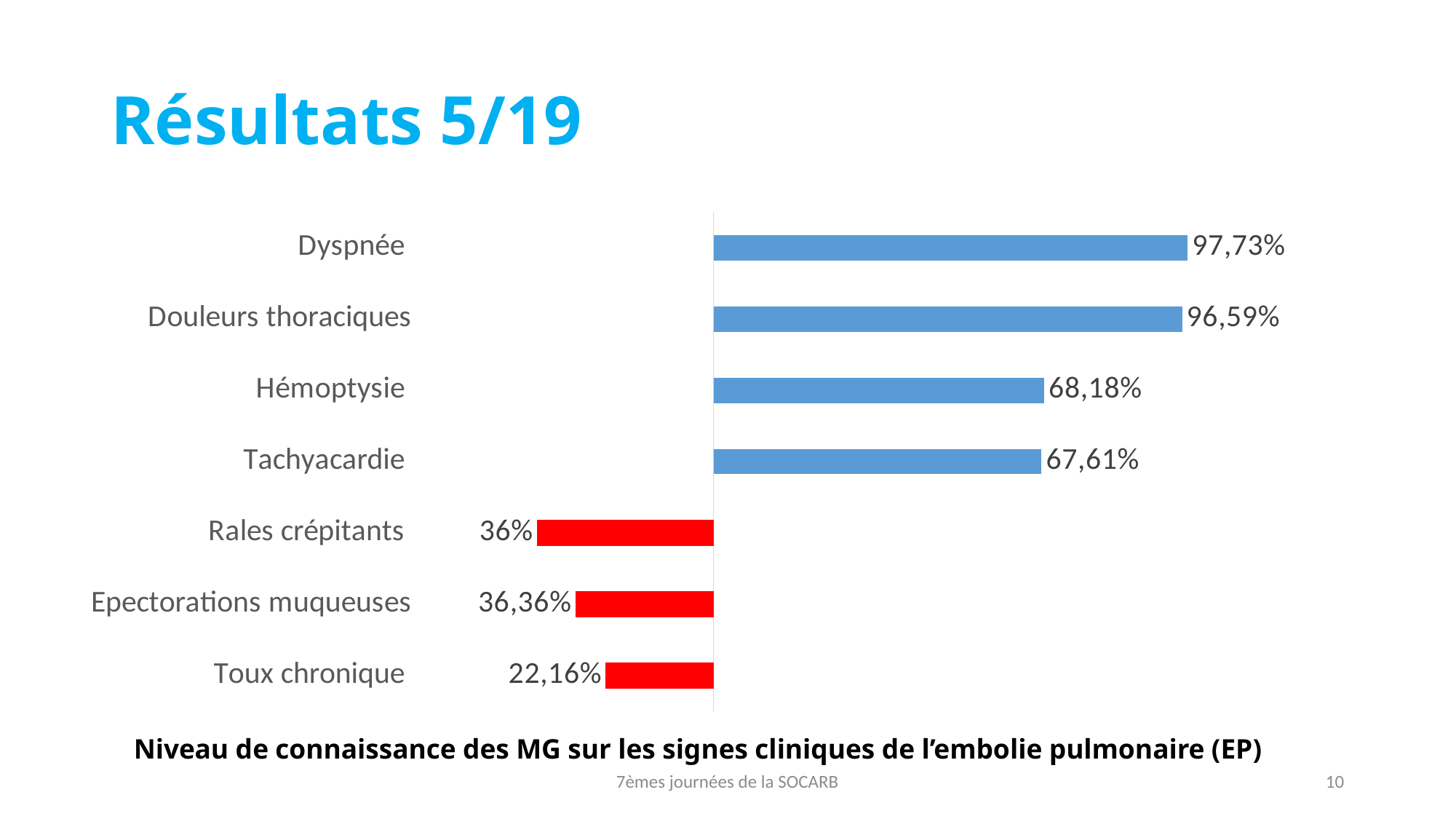
Which category has the highest value? Dyspnée What is the value shown for Epectorations muqueuses? 36,36% What is the value shown for Douleurs thoraciques? 96,59% What is the value shown for Hémoptysie? 68,18% What kind of chart is shown on the slide? Bar chart What is the difference between the values for Dyspnée and Douleurs thoraciques? 1,14 percentage points What is the value shown for Tachyacardie? 67,61% Which is larger, the value for Hémoptysie or the value for Toux chronique? Hémoptysie What is the value shown for Toux chronique? 22,16% What is the value shown for Dyspnée? 97,73% Which category has the smallest labelled value? Toux chronique How many categories are shown in the chart? 7